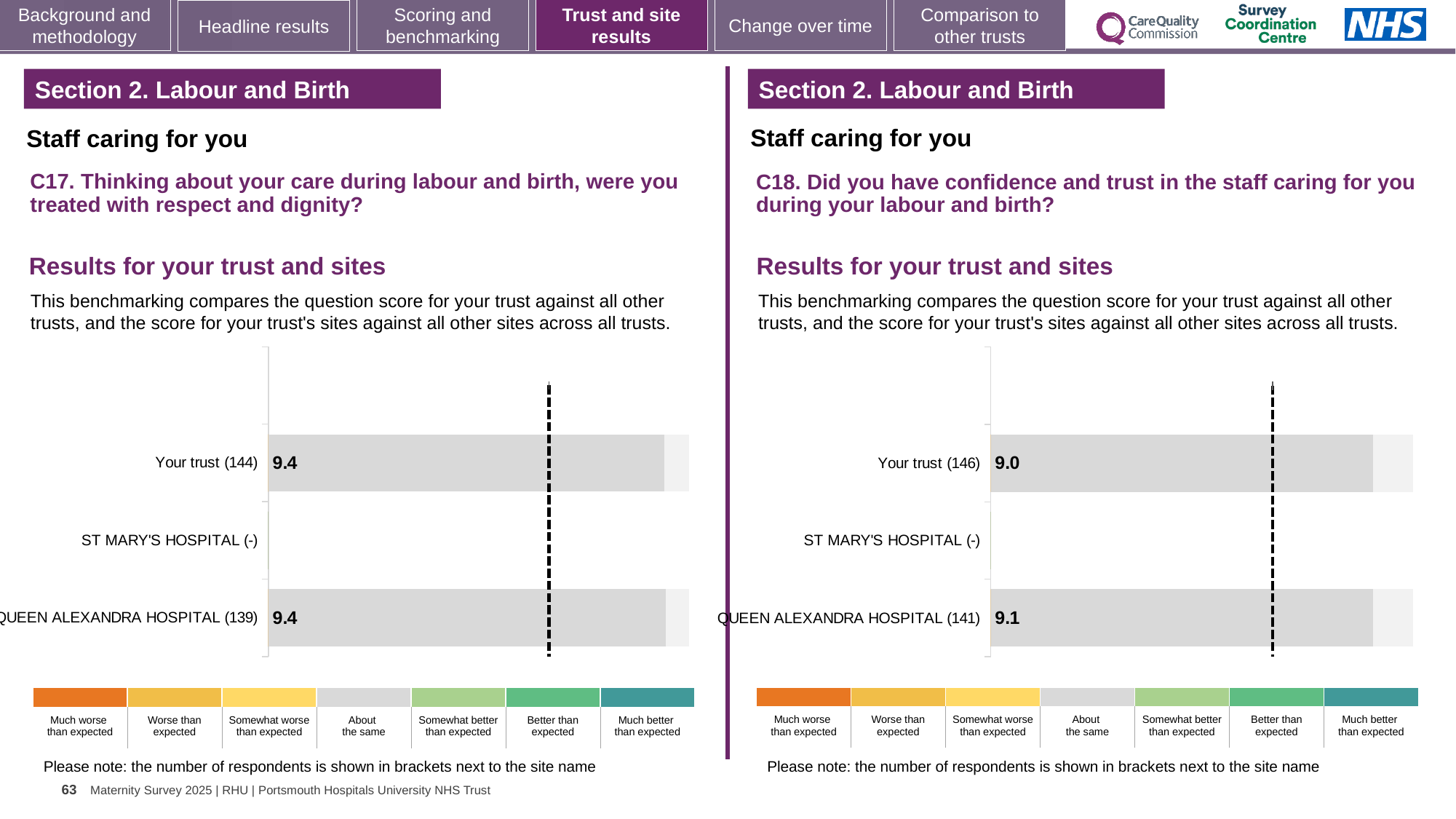
On the right chart (C18), what is the difference between the Queen Alexandra Hospital score and the Your trust score? 0.1 On the right chart (C18), how many respondents are shown in brackets for Queen Alexandra Hospital? 141 What type of chart is used on the right (C18)? Bar chart On the right chart (C18), what is the score for Queen Alexandra Hospital? 9.1 How many site/trust categories are listed on the left chart (C17)? 3 On the right chart (C18), which is higher, the score for Your trust or for Queen Alexandra Hospital? Queen Alexandra Hospital On the left chart (C17), how many respondents are shown in brackets for Your trust? 144 On the left chart (C17), what is the score for Queen Alexandra Hospital? 9.4 On the left chart (C17), what is the difference between the Your trust score and the Queen Alexandra Hospital score? 0.0 On the right chart (C18), what is the score for Your trust? 9.0 How many rating bands are shown in the colour legend below the left chart (C17)? 7 On the left chart (C17), what is the score for Your trust? 9.4